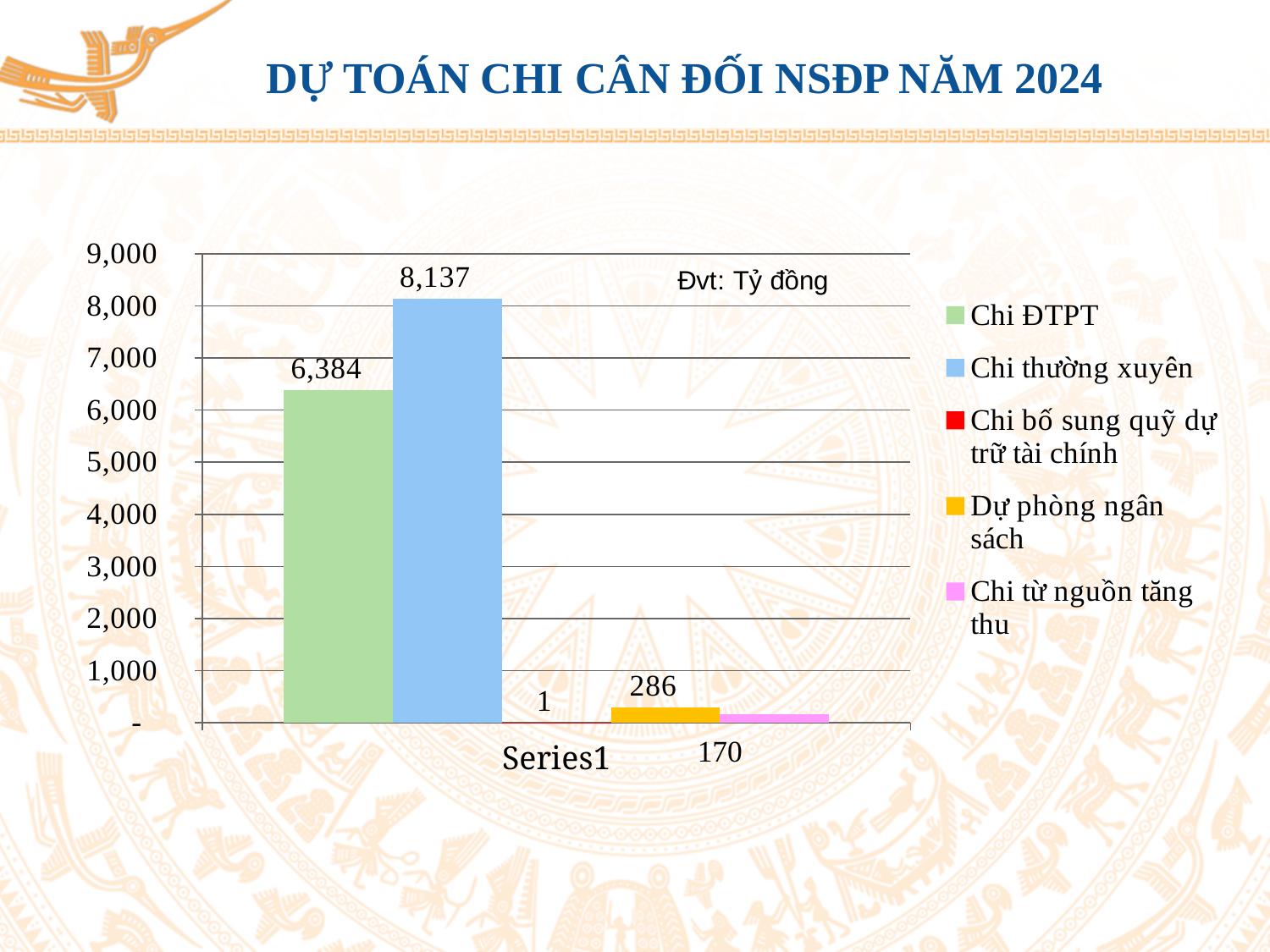
What is the value for Chi từ nguồn tăng thu? 170 Which series has the highest value? Chi thường xuyên What is the value for Chi bổ sung quỹ dự trữ tài chính? 1 What is the value for Chi thường xuyên? 8,137 What kind of chart is shown on the slide? Bar chart How many series does the legend list? 5 Which is larger, Dự phòng ngân sách or Chi từ nguồn tăng thu? Dự phòng ngân sách Which series has the lowest value? Chi bổ sung quỹ dự trữ tài chính What is the difference between Chi thường xuyên and Chi ĐTPT? 1,753 What unit is stated on the chart? Tỷ đồng What is the value for Chi ĐTPT? 6,384 What is the value for Dự phòng ngân sách? 286